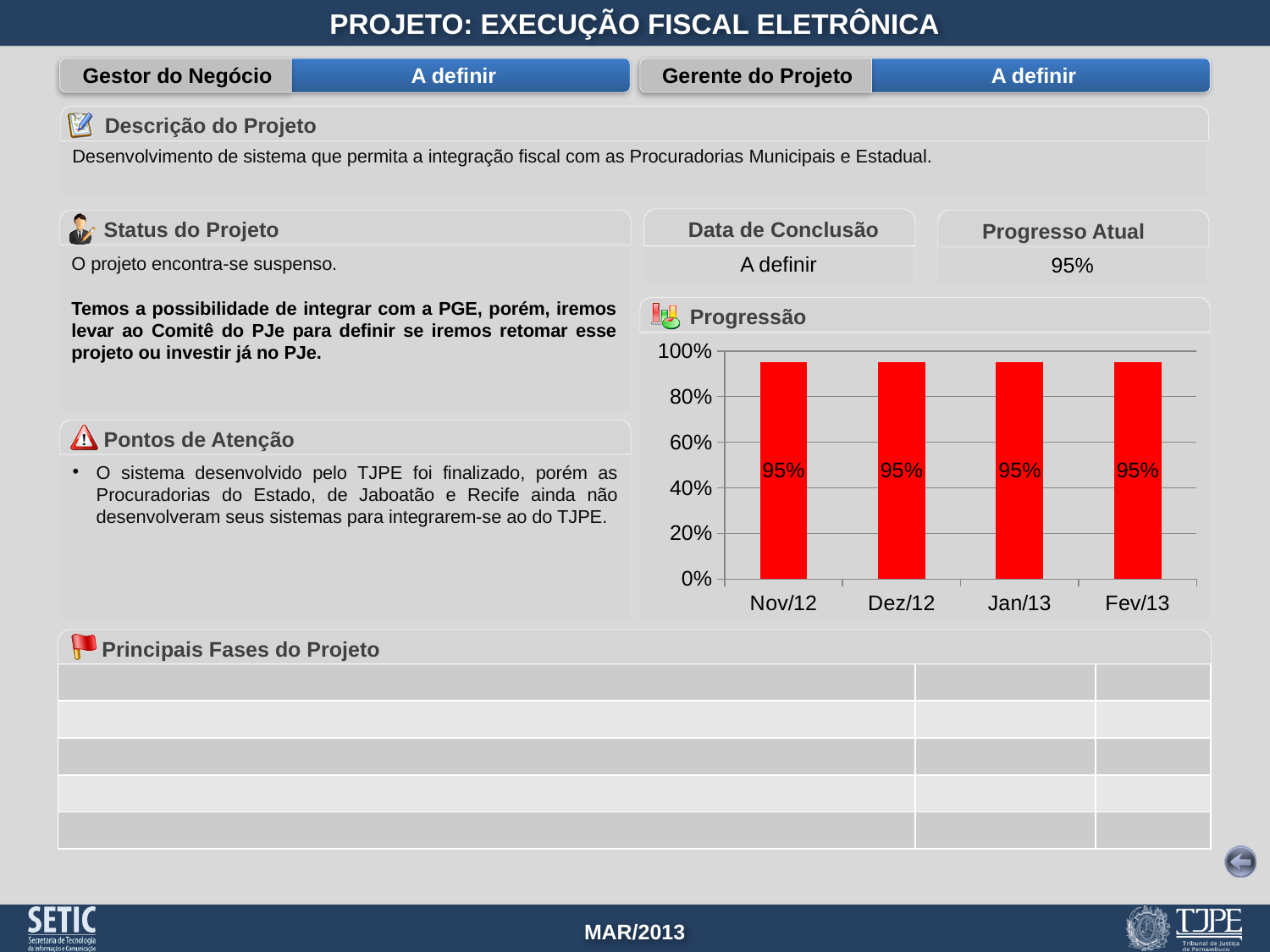
What is the value for Jan/13 in the Progressão chart? 95% What kind of chart is the Progressão chart? bar chart Is the value for Dez/12 in the Progressão chart greater or less than 80%? greater What colour are the bars in the Progressão chart? red Do the values in the Progressão chart rise, fall or stay flat from Nov/12 to Fev/13? stay flat Is the value for Nov/12 in the Progressão chart greater or less than 100%? less What is the value for Fev/13 in the Progressão chart? 95% What is the difference between the values for Dez/12 and Jan/13 in the Progressão chart? 0% What is the title of the chart on the slide? Progressão What is the value for Nov/12 in the Progressão chart? 95% How many categories are shown on the x axis of the Progressão chart? 4 What is the first category on the x axis of the Progressão chart? Nov/12